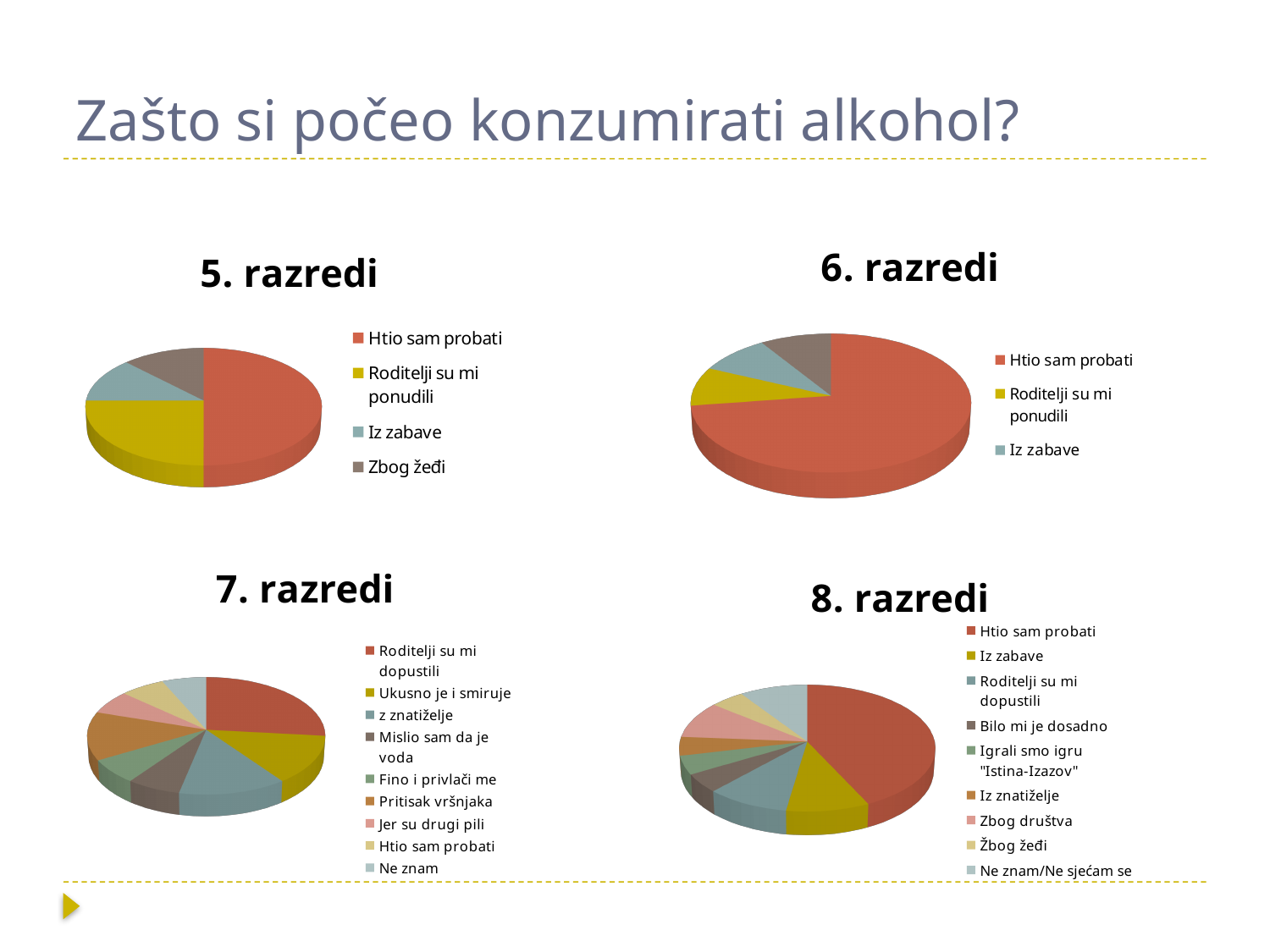
In the "5. razredi" chart, how many categories does the legend list? 4 In the "8. razredi" chart, which slice is larger: "Htio sam probati" or "Iz zabave"? Htio sam probati In the "8. razredi" chart, which category has the largest slice? Htio sam probati In the "6. razredi" chart, how many entries does the legend list? 3 How many pie charts are shown on the slide? 4 What kind of chart is the "5. razredi" chart? Pie chart In the "5. razredi" chart, which category has the largest slice? Htio sam probati In the "5. razredi" chart, which slice is larger: "Htio sam probati" or "Roditelji su mi ponudili"? Htio sam probati In the "7. razredi" chart, how many categories does the legend list? 9 In the "7. razredi" chart, which category has the largest slice? Roditelji su mi dopustili